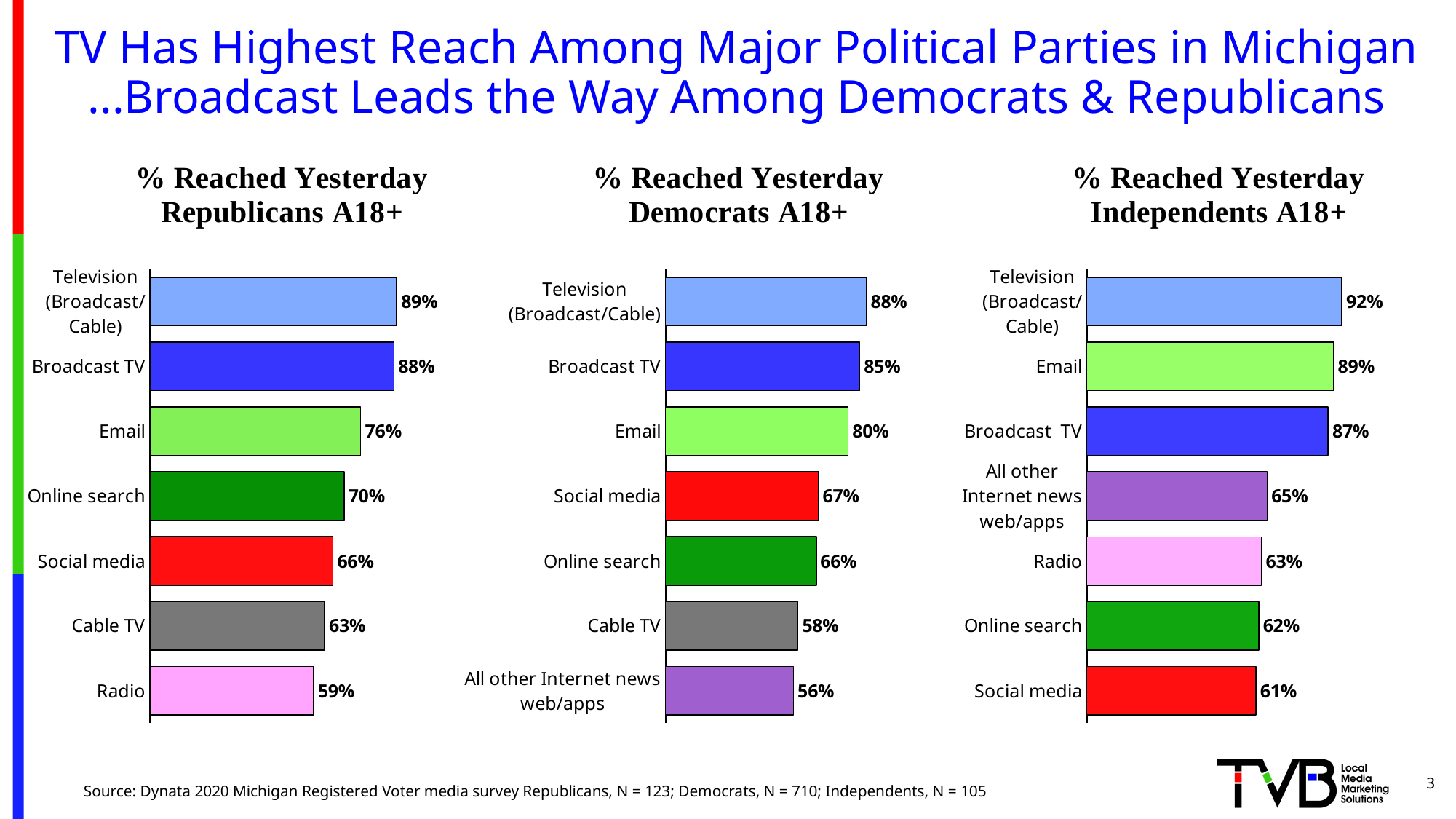
What type of chart is the '% Reached Yesterday Republicans A18+' chart? Bar chart In the '% Reached Yesterday Republicans A18+' chart, what is the difference between Television (Broadcast/Cable) and Radio? 30 percentage points In the '% Reached Yesterday Independents A18+' chart, which category has the highest value? Television (Broadcast/Cable) In the '% Reached Yesterday Republicans A18+' chart, which category has the lowest value? Radio In the '% Reached Yesterday Republicans A18+' chart, what is the value for Email? 76% How many categories are shown in the '% Reached Yesterday Democrats A18+' chart? 7 In the '% Reached Yesterday Democrats A18+' chart, what is the value for Social media? 67% How many charts are shown on the slide? 3 In the '% Reached Yesterday Independents A18+' chart, which is larger: Email or Broadcast TV? Email In the '% Reached Yesterday Democrats A18+' chart, what is the difference between Broadcast TV and Cable TV? 27 percentage points In the '% Reached Yesterday Independents A18+' chart, what is the value for Radio? 63% In the '% Reached Yesterday Democrats A18+' chart, which category has the lowest value? All other Internet news web/apps